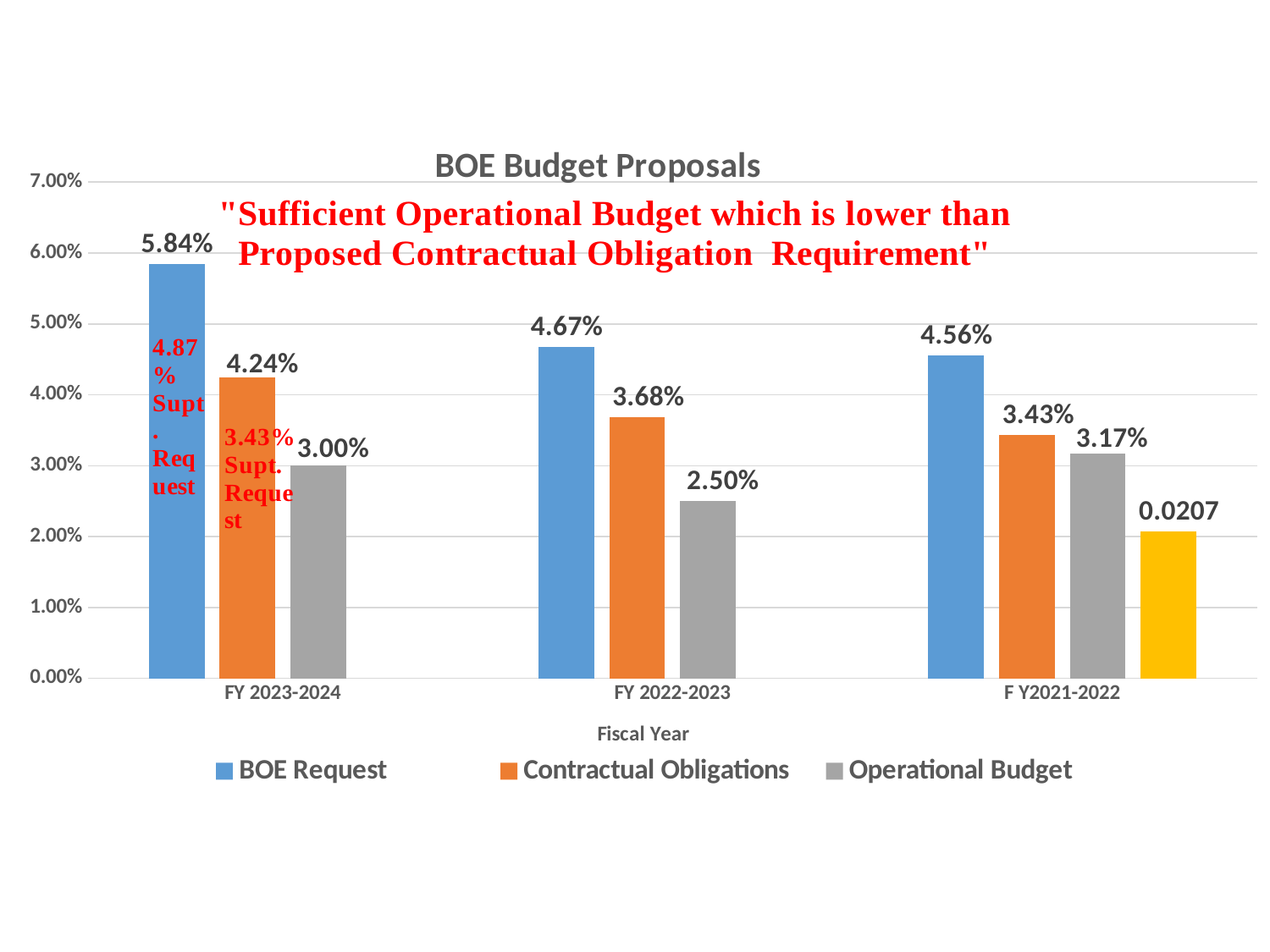
What is the BOE Request value for FY 2023-2024? 5.84% Which is larger for FY2021-2022: the Contractual Obligations value or the Operational Budget value? Contractual Obligations How many fiscal years are shown on the x axis? 3 What type of chart is shown on the slide? bar chart What is the difference between the BOE Request and the Contractual Obligations values for FY 2023-2024? 1.60% How many series does the legend list? 3 What is the Contractual Obligations value for FY 2022-2023? 3.68% Which fiscal year has the lowest Operational Budget value? FY 2022-2023 Do the BOE Request values rise or fall from FY 2023-2024 to FY2021-2022 along the x axis? fall What is the title of the chart? BOE Budget Proposals Which fiscal year has the highest BOE Request value? FY 2023-2024 What is the Operational Budget value for FY2021-2022? 3.17%